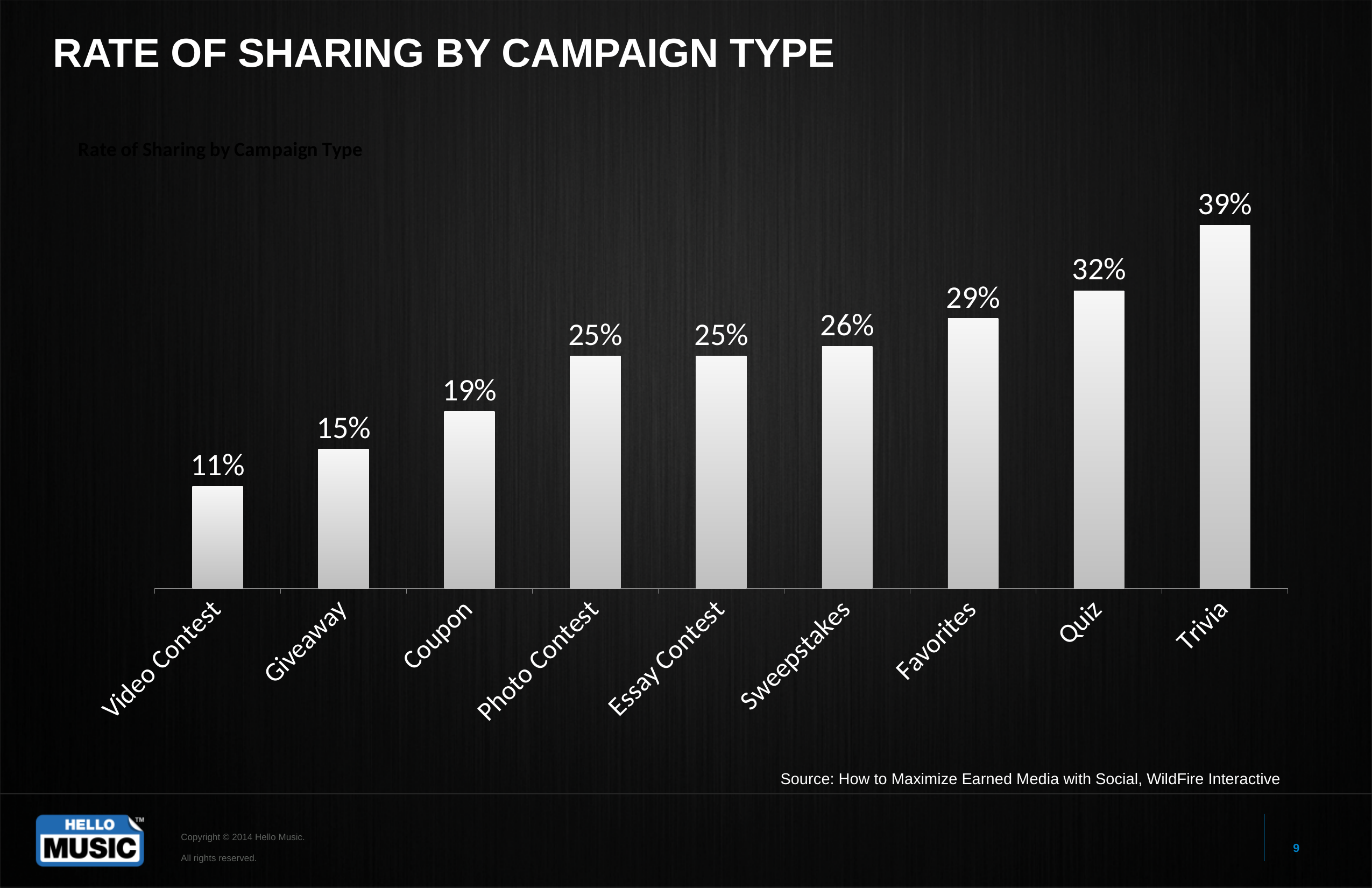
What kind of chart is shown on the slide? Bar chart Which has a higher rate of sharing, Coupon or Giveaway? Coupon What is the difference in rate of sharing between Quiz and Giveaway campaigns? 17% How many campaign types are shown in the chart? 9 What is the rate of sharing for Sweepstakes campaigns? 26% What is the rate of sharing for Video Contest campaigns? 11% What is the rate of sharing for Trivia campaigns? 39% Which campaign type has the highest rate of sharing? Trivia What is the difference in rate of sharing between Favorites and Coupon campaigns? 10% Which has a higher rate of sharing, Quiz or Favorites? Quiz Which campaign type has the lowest rate of sharing? Video Contest Do the rates of sharing rise or fall from left to right across the campaign types? Rise